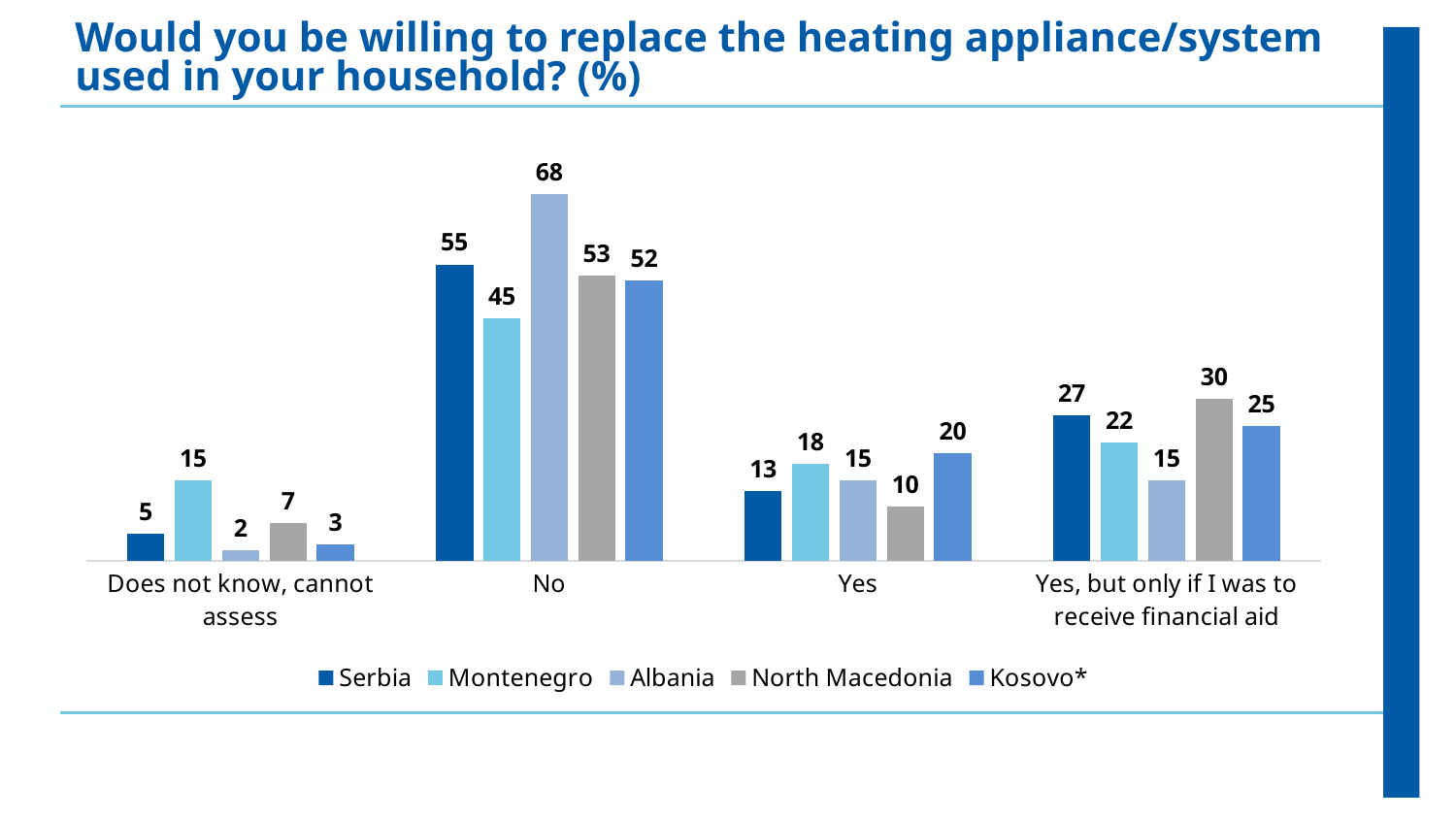
What kind of chart is shown on the slide? Bar chart What is the difference between North Macedonia and Albania in the "Yes, but only if I was to receive financial aid" category? 15 Which country has the highest value in the "No" category? Albania Which country has the lowest value in the "Does not know, cannot assess" category? Albania How many response categories are shown on the x axis? 4 Which country is listed first in the legend? Serbia How many series does the legend list? 5 What is the value for Kosovo* in the "Yes" category? 20 What is the value for North Macedonia in the "Yes, but only if I was to receive financial aid" category? 30 What is the value for Albania in the "No" category? 68 What is the difference between Serbia and Montenegro in the "No" category? 10 Which is larger in the "Yes" category: Montenegro or North Macedonia? Montenegro